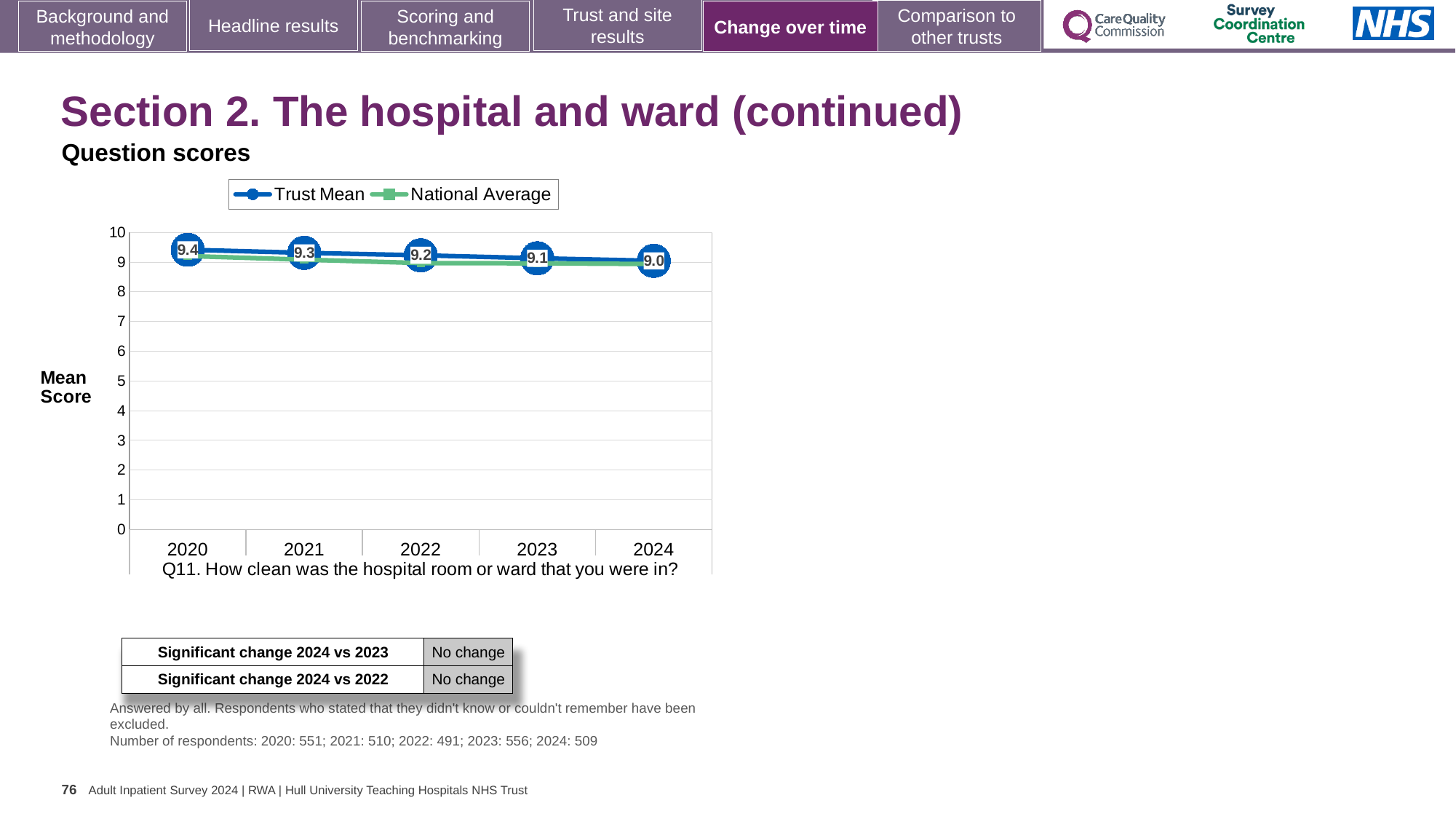
In which year is the Trust Mean lowest? 2024 What is the Trust Mean value for 2022? 9.2 What is the Trust Mean value for 2020? 9.4 How many series does the legend list? 2 Is the National Average value for 2024 greater or less than 8? greater What kind of chart is shown? Line chart Does the Trust Mean rise or fall from 2020 to 2024? Fall Which is larger, the Trust Mean in 2021 or in 2023? 2021 What is the Trust Mean value for 2024? 9.0 What is the difference between the Trust Mean in 2020 and in 2024? 0.4 How many years are shown on the x axis? 5 In which year is the Trust Mean highest? 2020